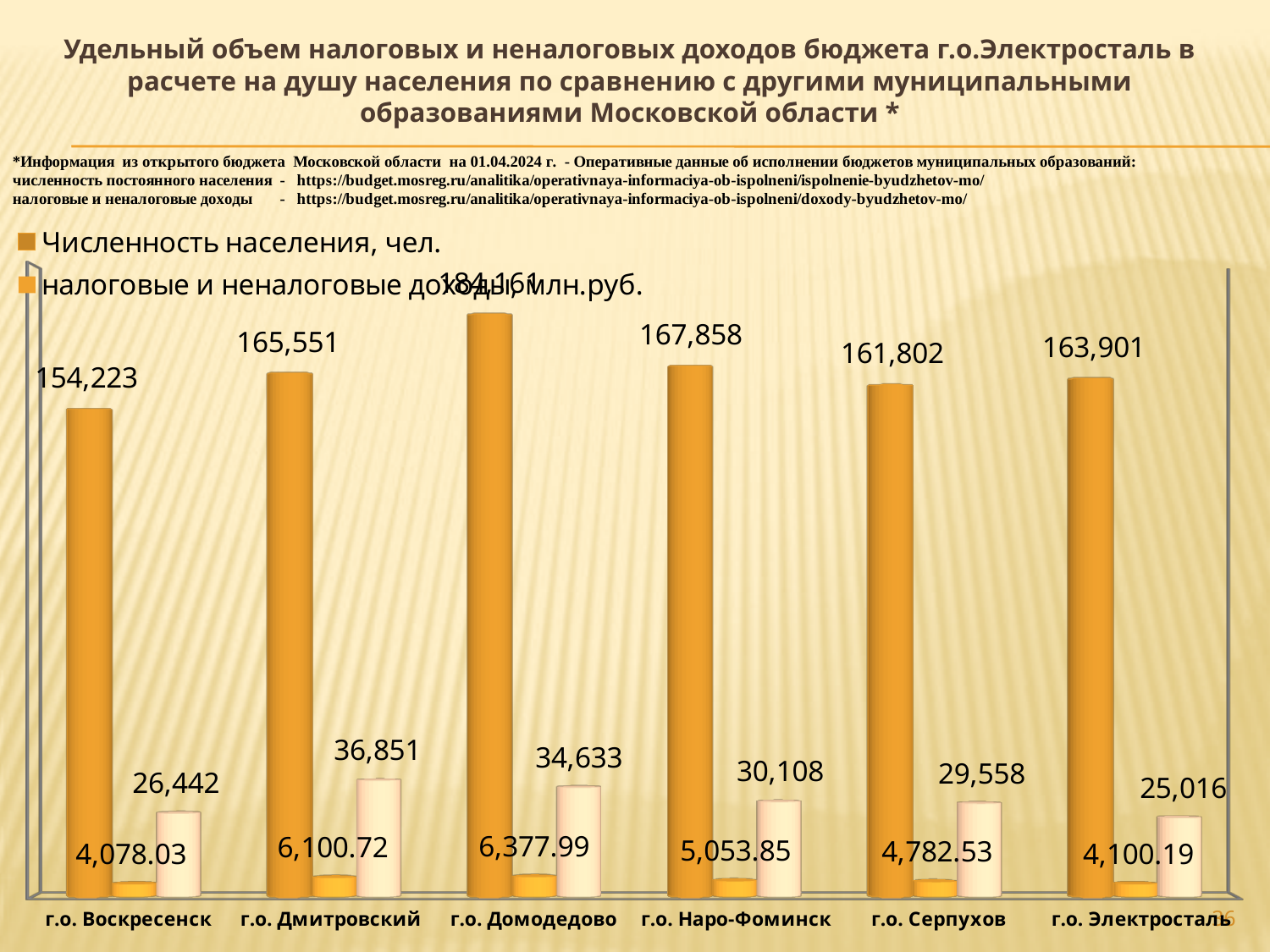
What is the difference between the light-coloured bar values for г.о. Дмитровский (36,851) and г.о. Электросталь (25,016)? 11,835 What is the population (Численность населения, чел.) shown for г.о. Электросталь? 163,901 Which municipality has the lowest tax and non-tax revenues (млн.руб.) on the chart? г.о. Воскресенск What is the difference in population between г.о. Домодедово and г.о. Воскресенск? 29,938 Which municipality has the highest population value on the chart? г.о. Домодедово What are the tax and non-tax revenues (налоговые и неналоговые доходы, млн.руб.) shown for г.о. Домодедово? 6,377.99 How many series does the legend list? 2 Which municipality has the lowest population value on the chart? г.о. Воскресенск Which has the larger population, г.о. Дмитровский or г.о. Серпухов? г.о. Дмитровский What is the value of the light-coloured (third) bar for г.о. Дмитровский? 36,851 How many municipalities are shown on the chart? 6 What kind of chart is shown on the slide? Bar chart